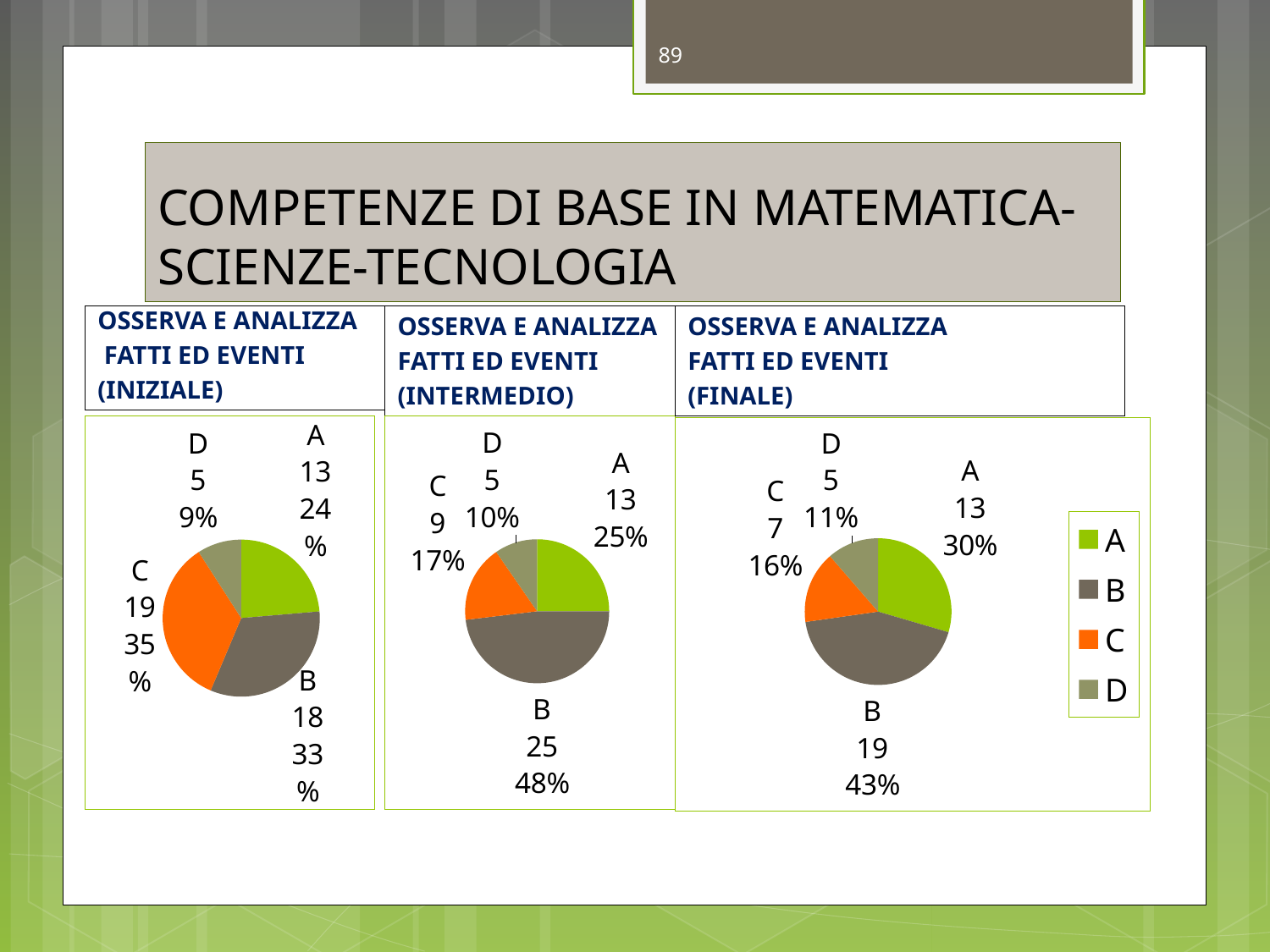
In the FINALE pie chart, what count is shown for category C? 7 What type of chart is used on this slide? Pie chart In the INIZIALE pie chart, which category has the smallest share? D In the INTERMEDIO pie chart, which is larger, the share for C or the share for D? C In the INIZIALE pie chart, what is the difference between the counts for C and A? 6 In the INTERMEDIO pie chart, which category has the largest share? B How many categories does each pie chart show? 4 In the FINALE pie chart, which category has the largest share? B In the INIZIALE pie chart, what percentage is shown for category C? 35% What colour represents category C in the legend? Orange In the FINALE pie chart, what percentage is shown for category A? 30% In the INTERMEDIO pie chart, what count is shown for category B? 25